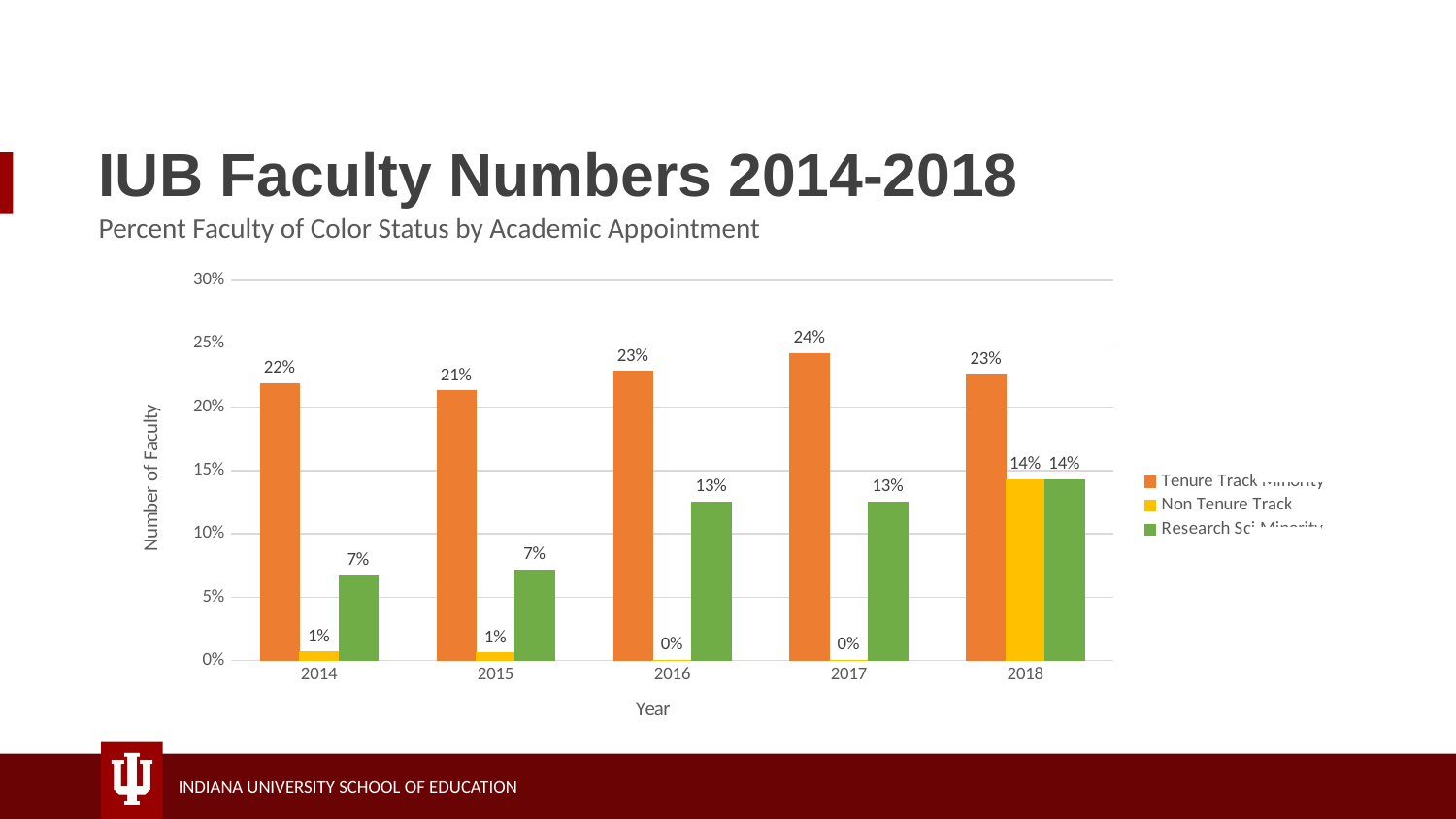
What is the Tenure Track value for 2017? 24% In which year is the Tenure Track value lowest? 2015 In which year is the Tenure Track value highest? 2017 How many years are shown on the x axis? 5 What is the Non Tenure Track value for 2018? 14% What is the difference between the Tenure Track value and the green (Research) series value in 2014? 15 percentage points How many series does the legend list? 3 What is the value of the green (Research) series for 2016? 13% What is the title of the y axis? Number of Faculty What is the difference between the Tenure Track value and the green (Research) series value in 2017? 11 percentage points What kind of chart is shown on the slide? Bar chart In 2018, which is larger: the Tenure Track value or the Non Tenure Track value? Tenure Track